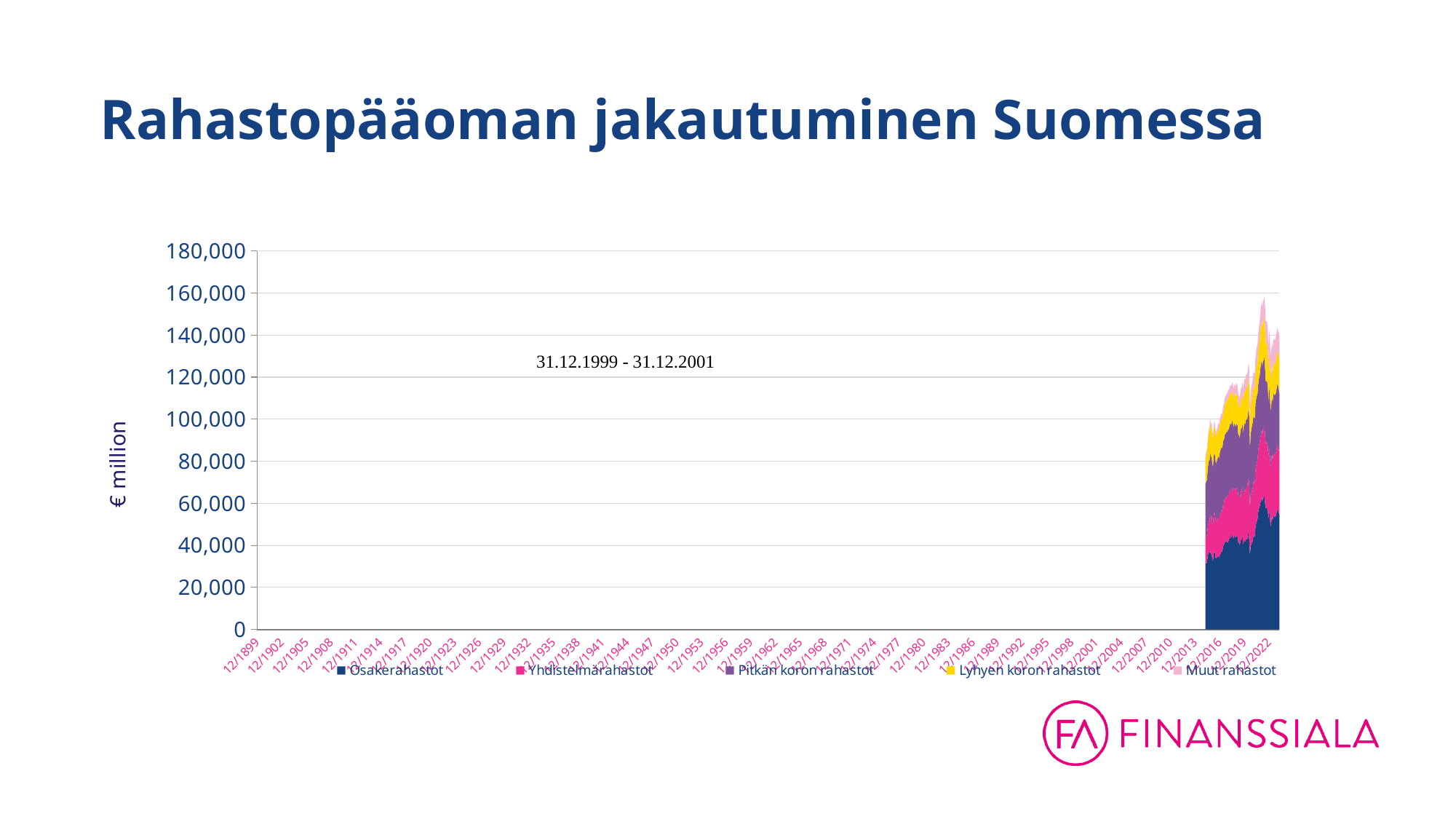
How many series does the legend list? 5 Does the stacked total generally rise or fall from 12/2016 to 12/2022? rise What is the highest value shown on the vertical axis? 180,000 Is the highest stacked total reached on the chart greater or less than 140,000? greater What is the label on the vertical axis? € million Is the stacked total at 12/2016 greater or less than 120,000? less Is the stacked total at the last point (12/2022) greater or less than 100,000? greater What is the title of the chart? Rahastopääoman jakautuminen Suomessa What kind of chart is shown on the slide? Stacked area chart